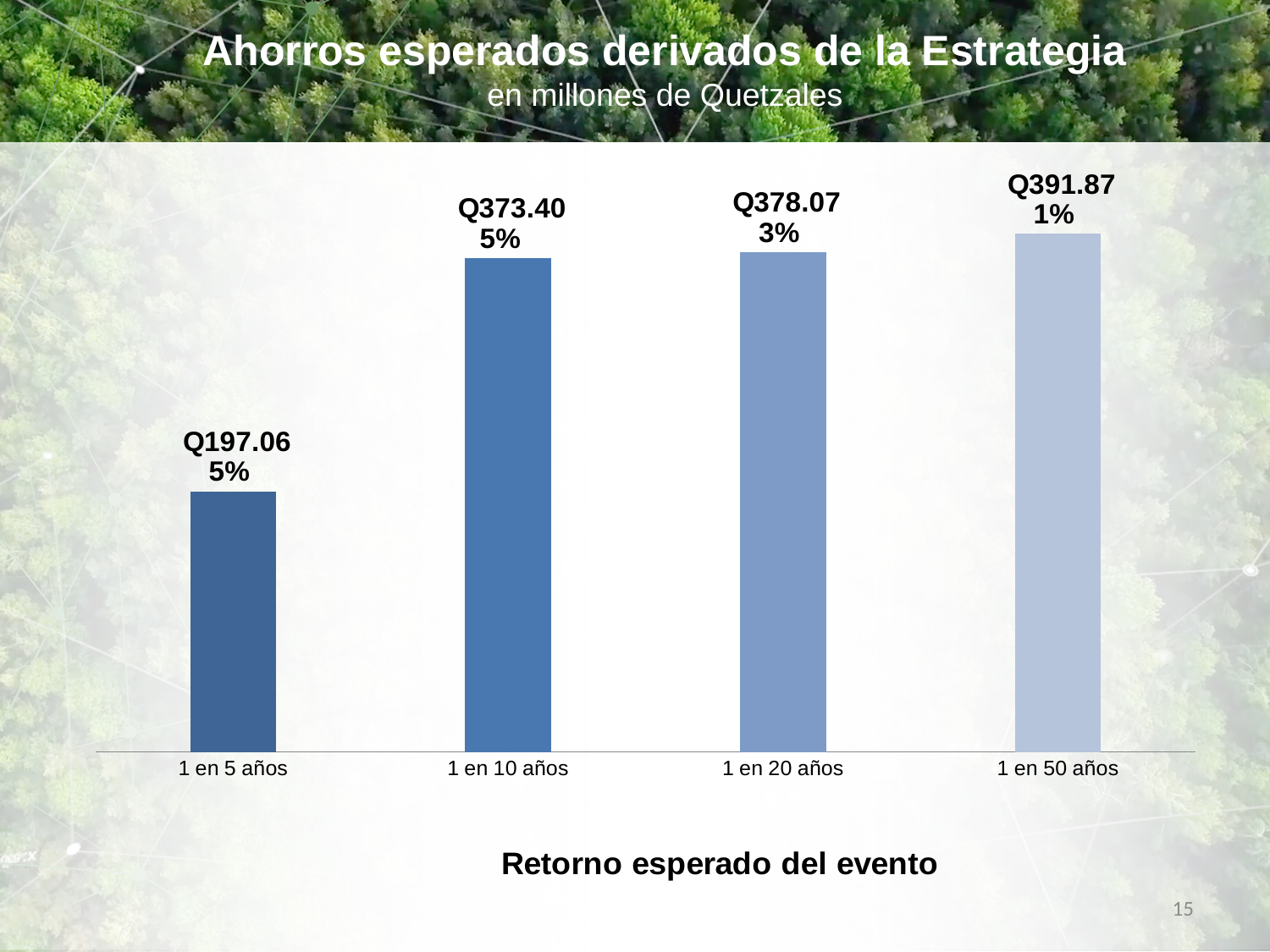
Do the expected savings values rise or fall from "1 en 5 años" to "1 en 50 años"? Rise Which has a larger expected savings value, "1 en 20 años" or "1 en 5 años"? 1 en 20 años Which category has the highest expected savings? 1 en 50 años Which category has the lowest expected savings? 1 en 5 años What percentage is shown above the bar for "1 en 20 años"? 3% What is the expected savings value for "1 en 10 años"? Q373.40 What is the expected savings value for "1 en 50 años"? Q391.87 What is the difference in expected savings between "1 en 50 años" and "1 en 5 años"? Q194.81 What is the difference in expected savings between "1 en 10 años" and "1 en 5 años"? Q176.34 How many categories are shown on the x axis? 4 What kind of chart is shown on the slide? Bar chart What is the expected savings value for "1 en 5 años"? Q197.06